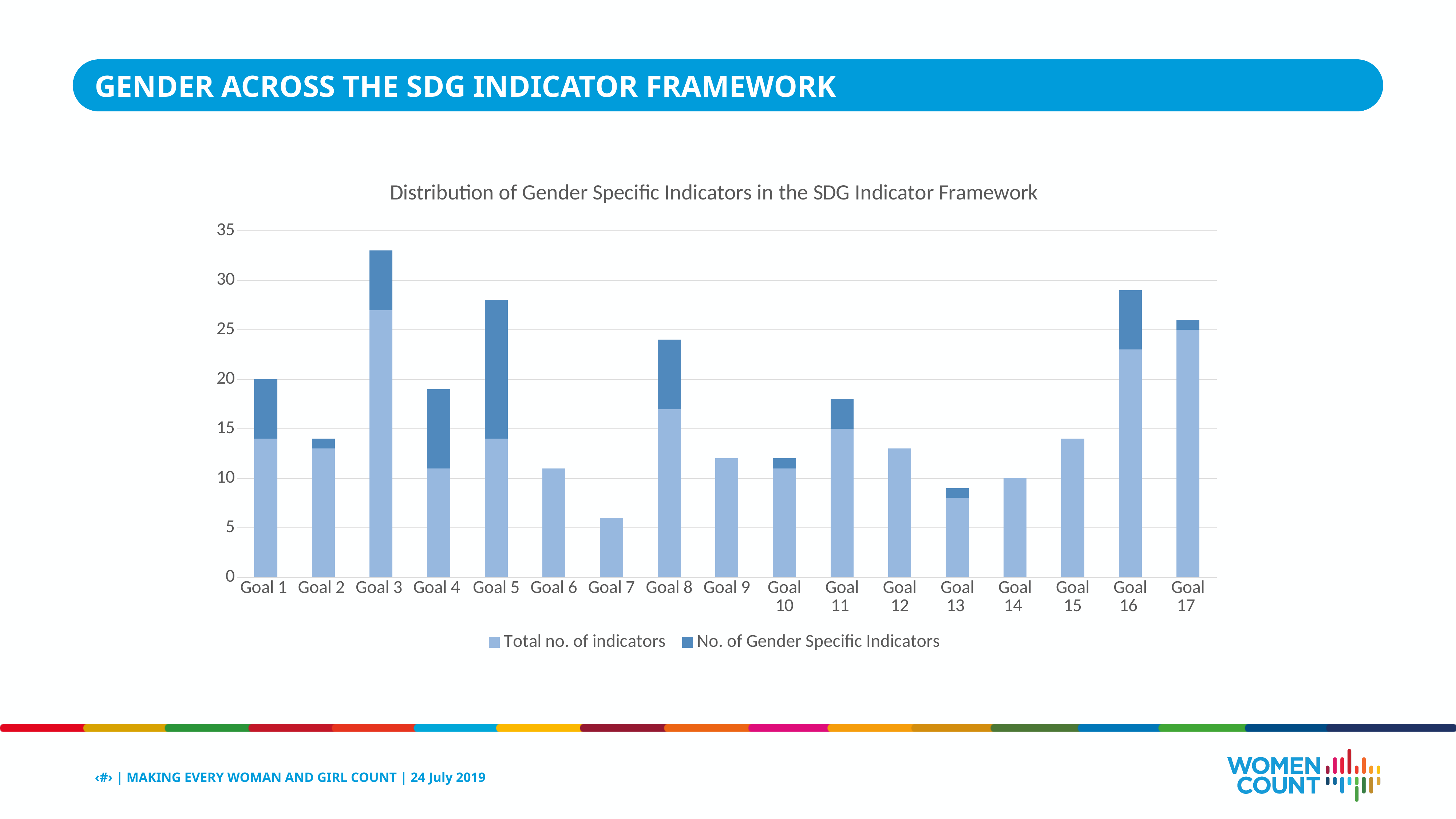
How many series does the legend list? 2 What is the title of the chart? Distribution of Gender Specific Indicators in the SDG Indicator Framework Which goal has the tallest stacked bar? Goal 3 What is the total height of the stacked bar for Goal 1? 20 Which stacked bar is taller, Goal 5 or Goal 8? Goal 5 How many goals (categories) are shown on the x axis? 17 Is the total height of the stacked bar for Goal 16 greater or less than 25? greater What is the total height of the stacked bar for Goal 14? 10 What kind of chart is shown on the slide? Stacked bar chart Which goal has the shortest stacked bar? Goal 7 Is the total height of the stacked bar for Goal 3 greater or less than 30? greater Is the total height of the stacked bar for Goal 7 greater or less than 10? less